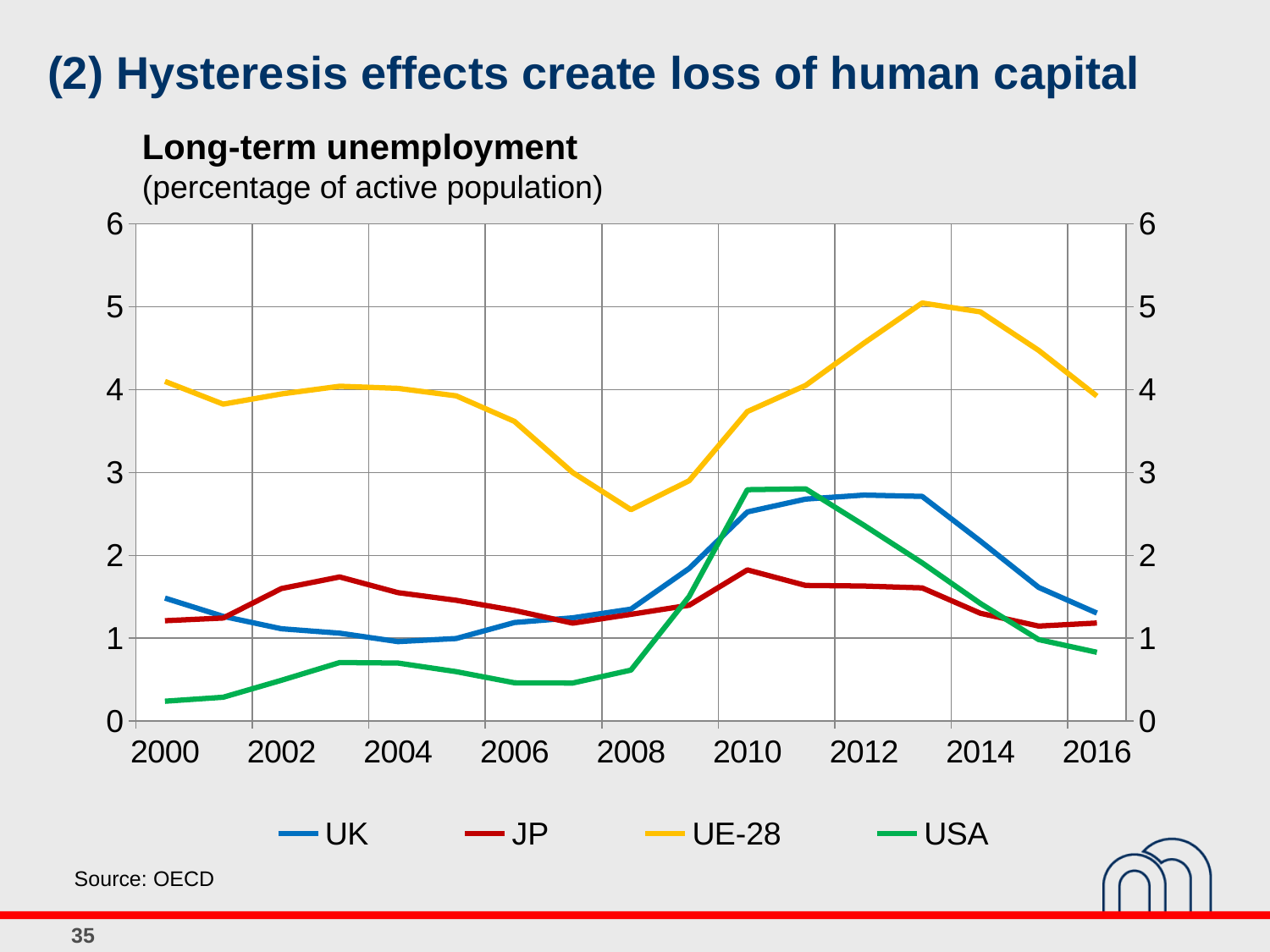
What kind of chart is shown on the slide? line chart Is the value for USA in 2000 greater or less than 1? less Which is larger in 2004, the value for UK or the value for JP? JP Which series has the lowest value in 2000? USA Does the UE-28 line rise or fall between 2008 and 2013? rise What is the title of the chart? Long-term unemployment Is the value for UK in 2012 greater or less than 2? greater Is the value for UE-28 in 2008 greater or less than 3? less How many series does the legend list? 4 Which series has the lowest value in 2016? USA Which series has the highest value in 2016? UE-28 Does the USA line rise or fall between 2011 and 2016? fall